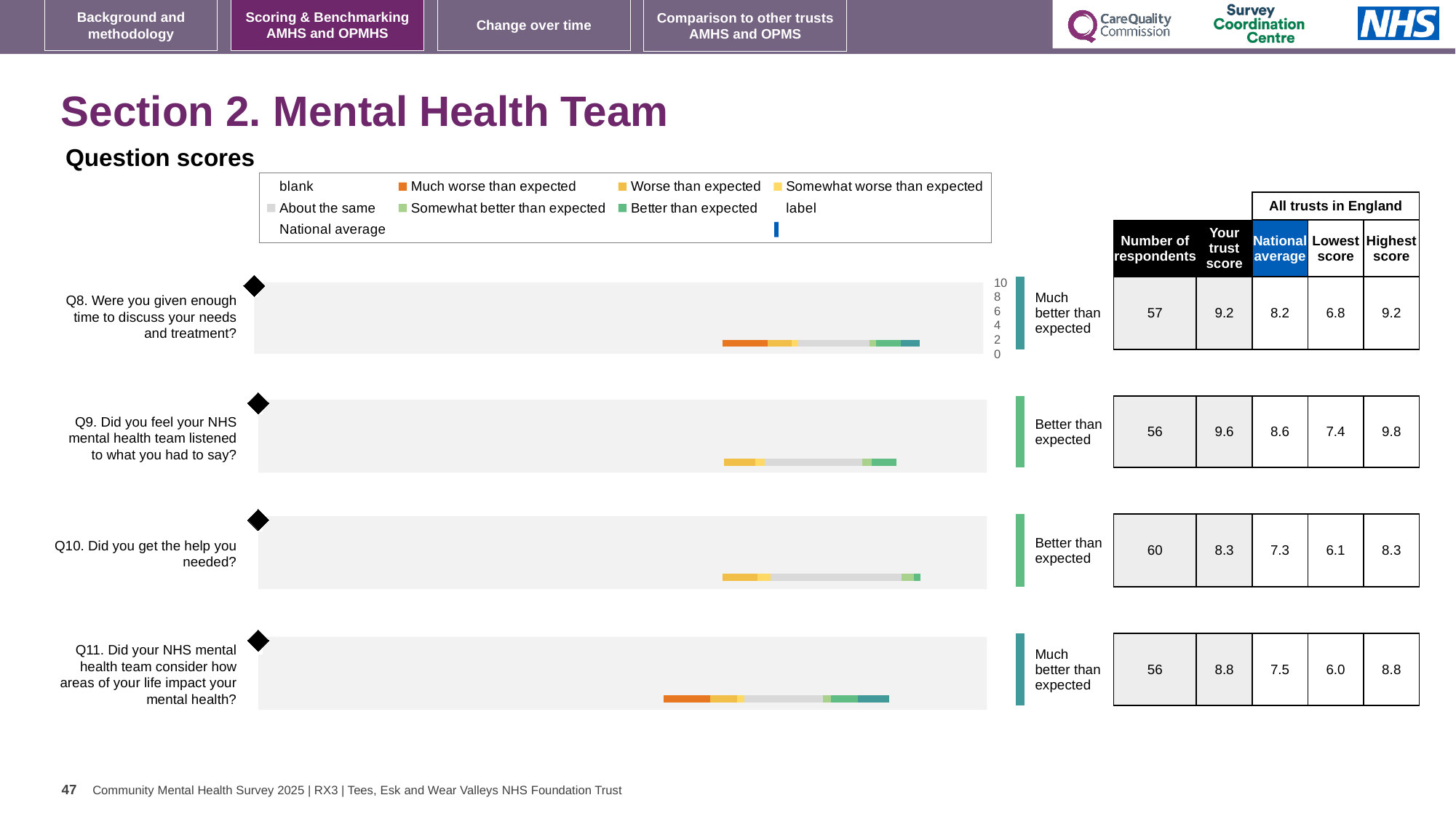
For the Q9 chart, what is the national average shown? 8.6 Which question has the lowest national average on this slide? Q10 For the Q8 chart, what is the 'Your trust score' value shown? 9.2 In the legend, what colour represents 'Much worse than expected'? orange For the Q11 chart, what is the lowest score among all trusts in England? 6.0 What rating label is shown next to the Q9 chart? Better than expected For Q8, which is larger: the trust score or the national average? the trust score What kind of chart is used to show the question scores for Q8 to Q11? bar chart How many questions (Q8 to Q11) have a chart on this slide? 4 Which question has the highest 'Your trust score' on this slide? Q9 For the Q10 chart, how many respondents are shown? 60 For Q11, what is the difference between the trust score and the national average? 1.3